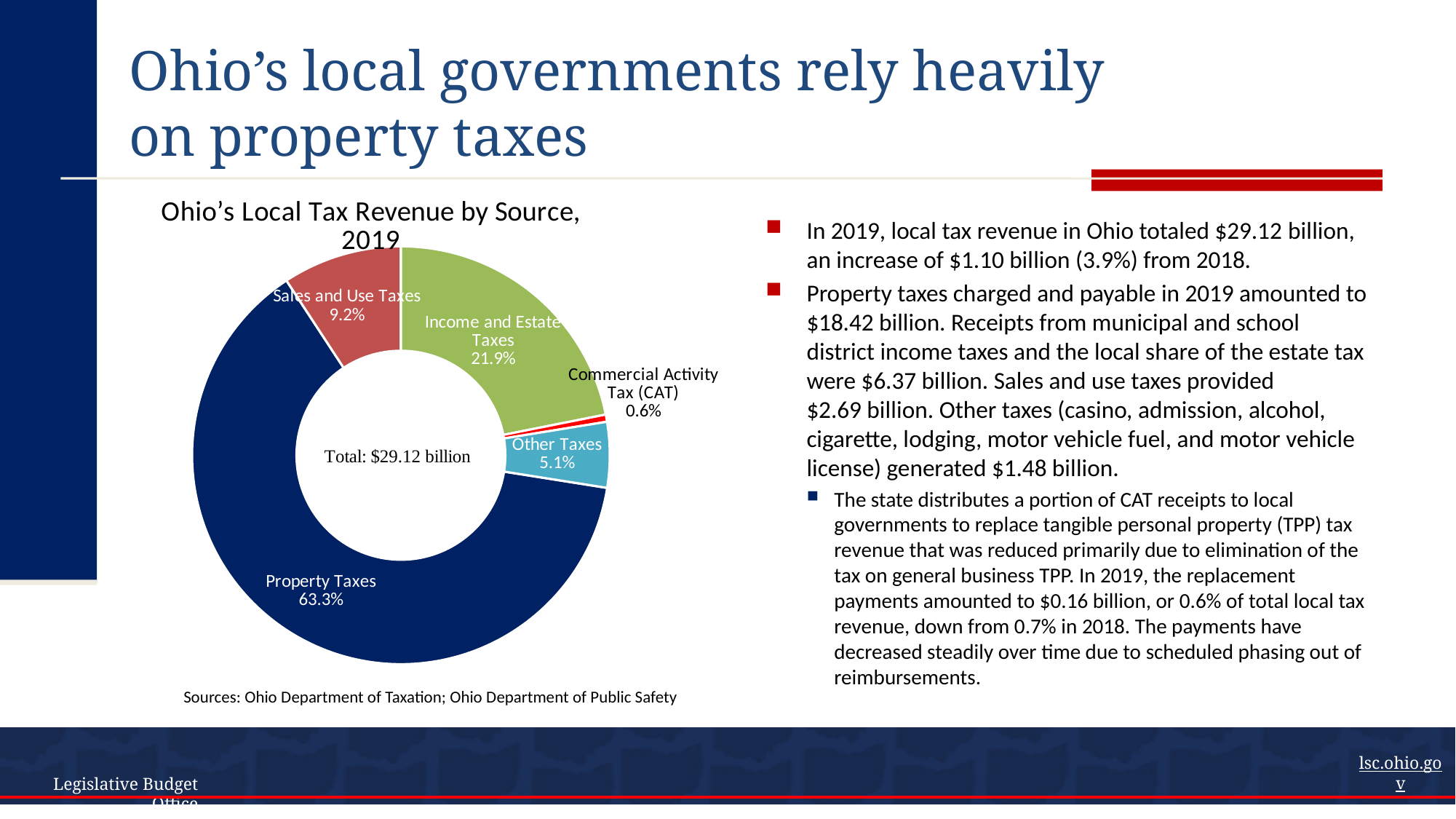
What kind of chart is used to show Ohio's local tax revenue by source? Pie chart (doughnut) What share of Ohio's local tax revenue in 2019 came from Property Taxes? 63.3% What share of Ohio's local tax revenue in 2019 came from the Commercial Activity Tax (CAT)? 0.6% Which source accounts for the largest share of Ohio's local tax revenue in 2019? Property Taxes Which source accounts for the smallest share of Ohio's local tax revenue in 2019? Commercial Activity Tax (CAT) What share of Ohio's local tax revenue in 2019 came from Sales and Use Taxes? 9.2% How many revenue sources are shown in the chart? 5 How many percentage points larger is the Property Taxes share than the Income and Estate Taxes share? 41.4 percentage points What share of Ohio's local tax revenue in 2019 came from Income and Estate Taxes? 21.9% What is the title of the chart? Ohio's Local Tax Revenue by Source, 2019 Which is larger: the share for Sales and Use Taxes or the share for Other Taxes? Sales and Use Taxes What total is printed in the center of the chart? Total: $29.12 billion